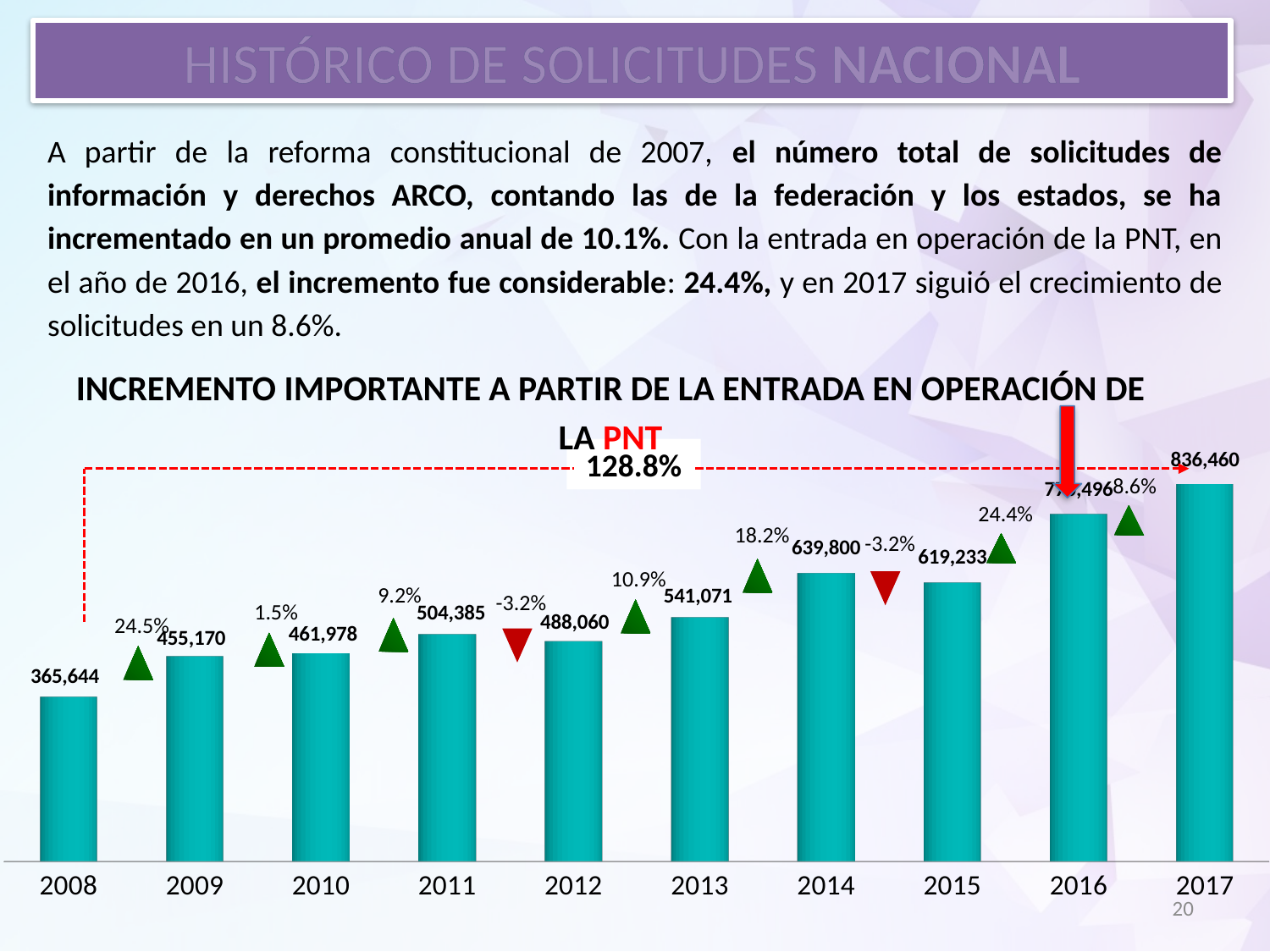
Which year has the highest value? 2017 Which is larger, the value for 2011 or the value for 2012? 2011 Which year has the lowest value? 2008 What kind of chart is this? bar chart What is the value for 2012? 488,060 What percentage change is shown between 2015 and 2016? 24.4% What is the value for 2017? 836,460 How many years are shown on the x axis? 10 What is the value for 2008? 365,644 What is the difference between the values for 2014 and 2015? 20,567 What is the value for 2014? 639,800 What is the difference between the values for 2017 and 2008? 470,816